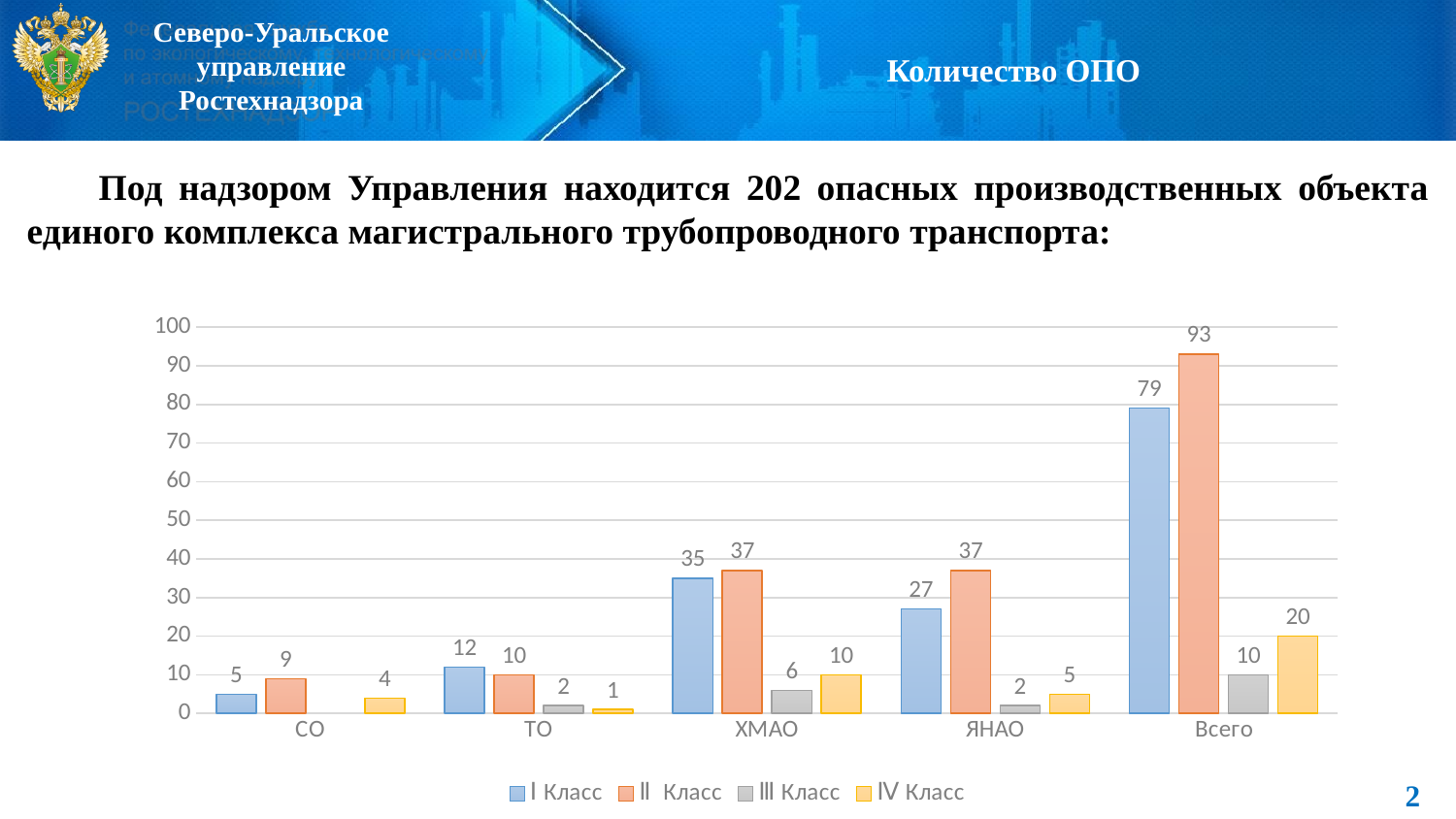
Excluding Всего, which category has the lowest value for II Класс? СО What is the value of IV Класс for ЯНАО? 5 Which category has the highest value for I Класс? Всего How many series does the legend list? 4 Which series is shown in orange in the legend? II Класс What is the value of I Класс for ХМАО? 35 What type of chart is shown on the slide? bar chart What is the value of II Класс for Всего? 93 What is the difference between II Класс and I Класс for Всего? 14 What is the value of III Класс for ТО? 2 Which is larger for ЯНАО: I Класс or II Класс? II Класс How many categories are shown on the x axis? 5